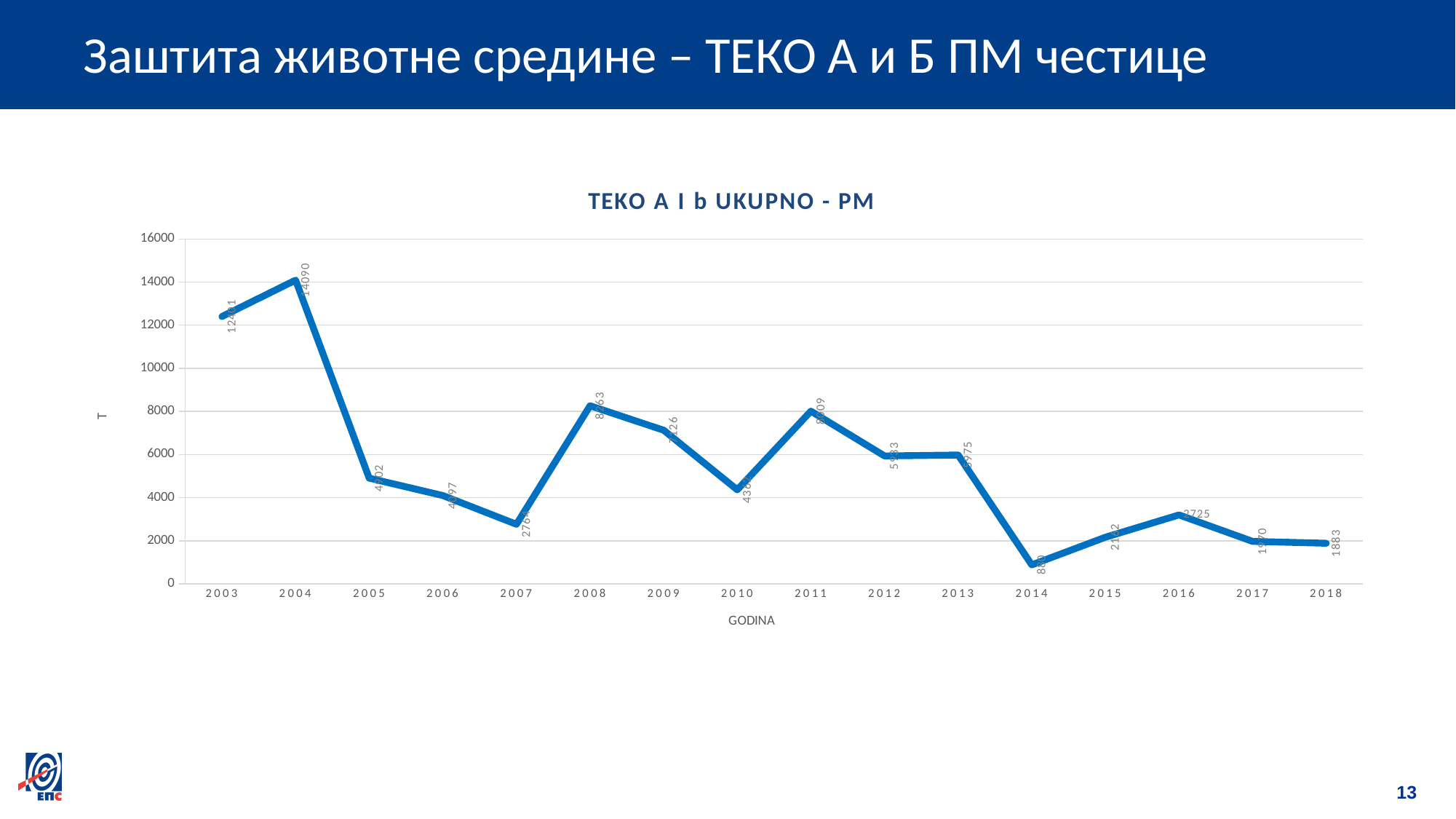
What type of chart is shown on the slide? line chart What is the value for 2016? 2725 What is the difference between the values for 2016 and 2015? 563 Which year has the lowest value? 2014 What is the value for 2012? 5933 Is the value for 2003 greater or less than 12000? greater What is the value for 2018? 1883 What is the title of the chart? TEKO A I b UKUPNO - PM What is the value for 2004? 14090 Overall, do the values rise or fall from 2003 to 2018? fall Which year has the highest value? 2004 How many years are plotted on the x axis? 16